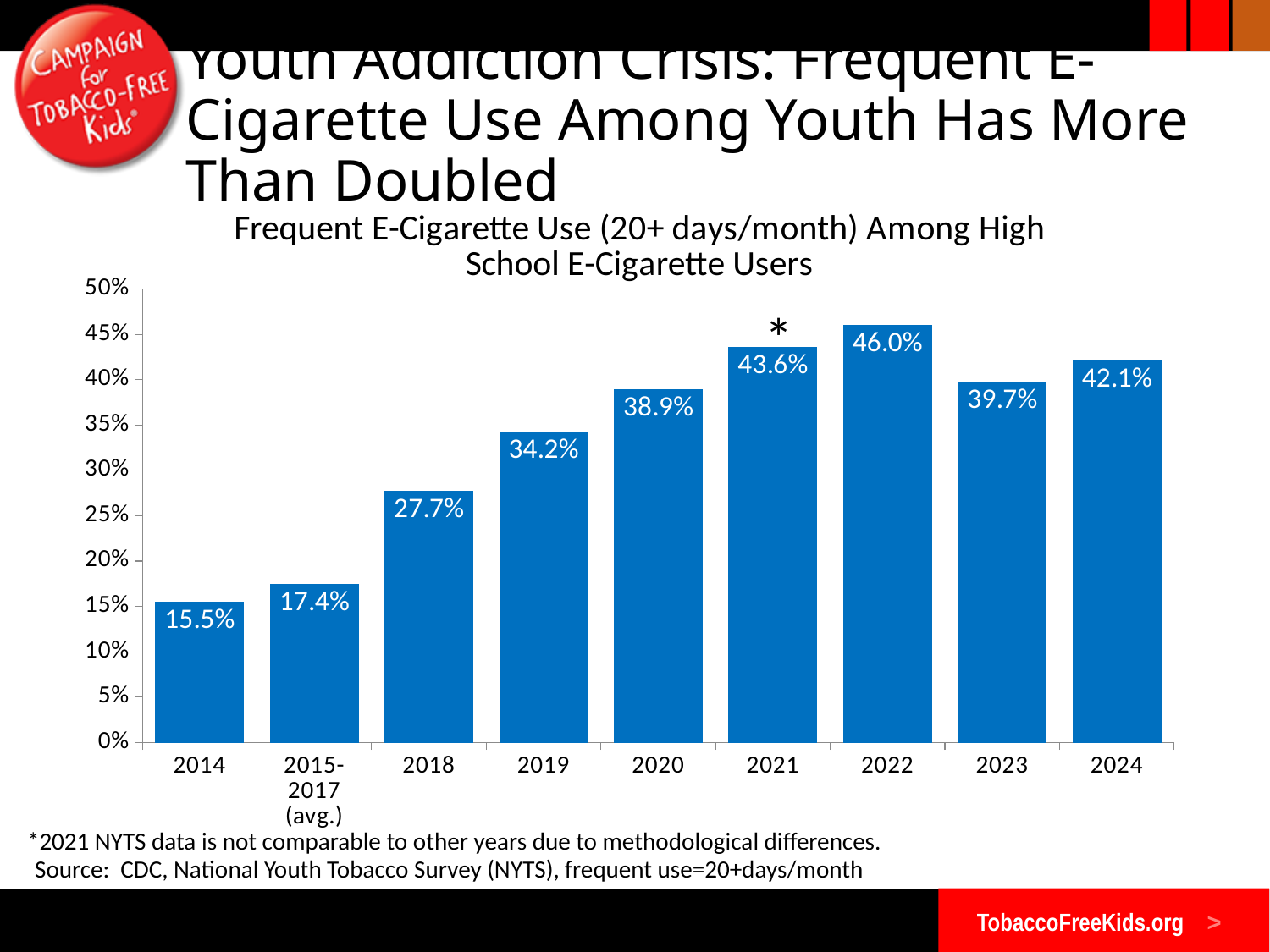
How many bars are shown in the chart? 9 What is the value for 2014? 15.5% Which year has the highest value? 2022 Which is larger, the value for 2019 or the value for 2020? 2020 Do the values generally rise or fall from 2014 to 2022? Rise What is the title of the chart? Frequent E-Cigarette Use (20+ days/month) Among High School E-Cigarette Users What is the value for 2015-2017 (avg.)? 17.4% What is the value for 2022? 46.0% Which category has the lowest value? 2014 What is the difference between the values for 2024 and 2023? 2.4% Is the value for 2018 greater or less than 25%? greater What kind of chart is shown on the slide? Bar chart